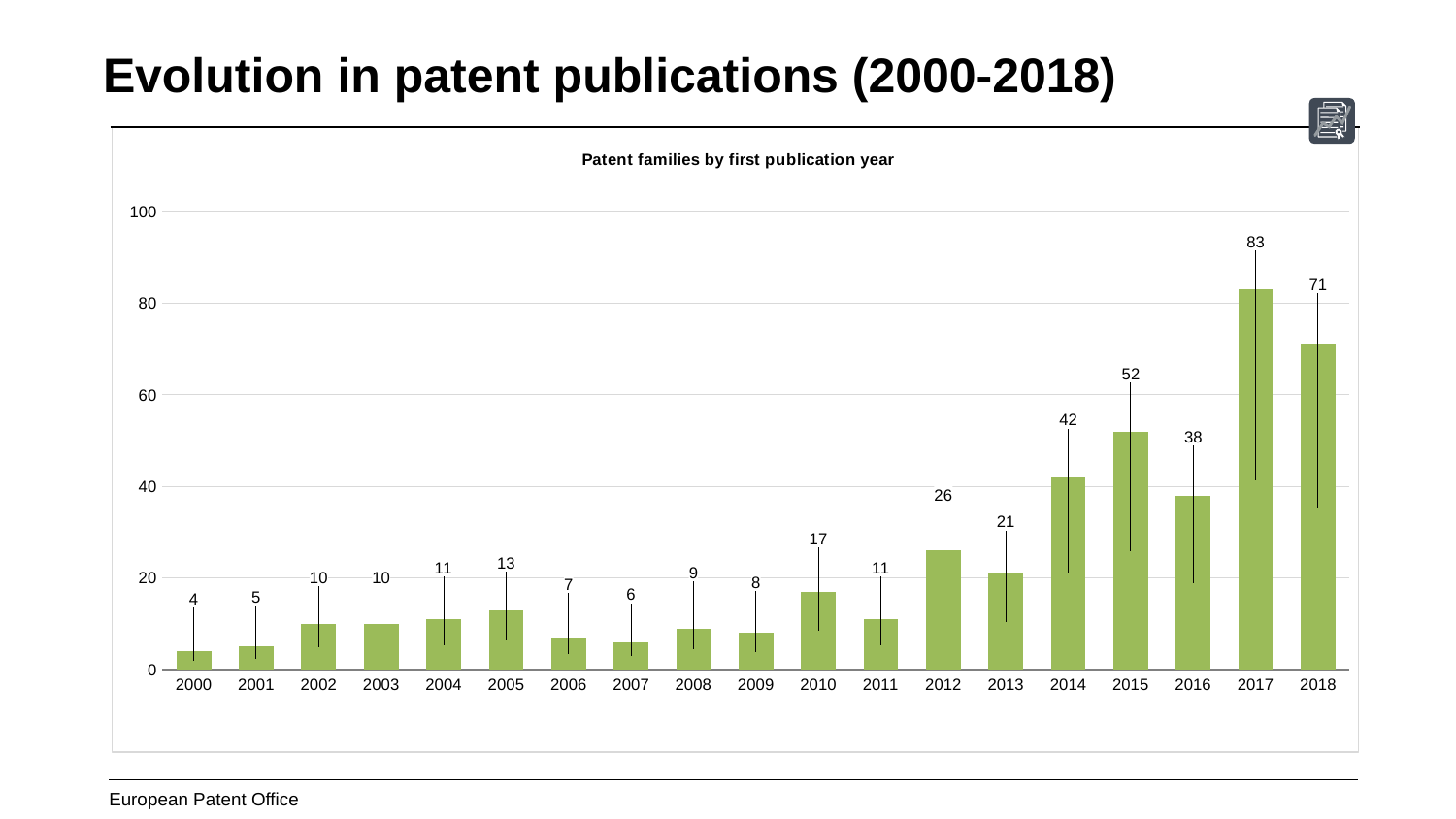
Which year has a larger value, 2014 or 2016? 2014 What is the number of patent families for 2017? 83 What is the number of patent families for 2000? 4 What is the title of the chart? Patent families by first publication year Do the values generally rise or fall from 2011 to 2017? rise What is the difference between the values for 2017 and 2018? 12 What is the number of patent families for 2010? 17 What kind of chart is shown on the slide? bar chart Which year has the lowest number of patent families? 2000 Which year has the highest number of patent families? 2017 How many years are shown on the x axis? 19 Is the value for 2015 greater or less than 40? greater